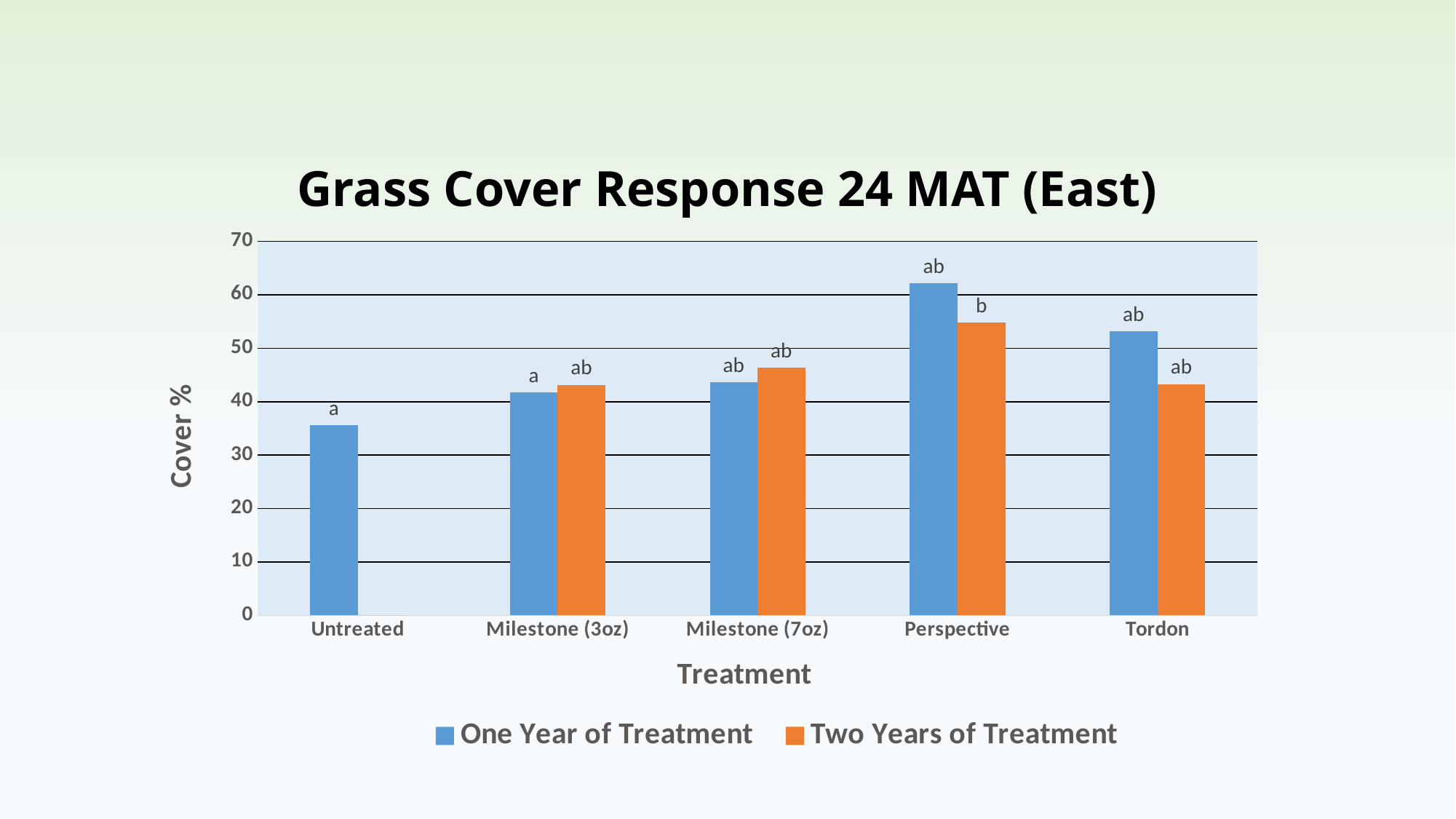
How many treatment categories are shown on the x axis? 5 How many series does the legend list? 2 For Perspective, which is larger: the One Year of Treatment bar or the Two Years of Treatment bar? One Year of Treatment Is the One Year of Treatment value for Untreated greater or less than 40? less What is the title of the chart? Grass Cover Response 24 MAT (East) Which treatment has the highest One Year of Treatment bar? Perspective Which treatment has the highest Two Years of Treatment bar? Perspective For Tordon, which is larger: the One Year of Treatment bar or the Two Years of Treatment bar? One Year of Treatment Is the Two Years of Treatment value for Perspective greater or less than 50? greater What kind of chart is shown on the slide? bar chart What letter label is printed above the Two Years of Treatment bar for Perspective? b Which treatment has the lowest One Year of Treatment bar? Untreated